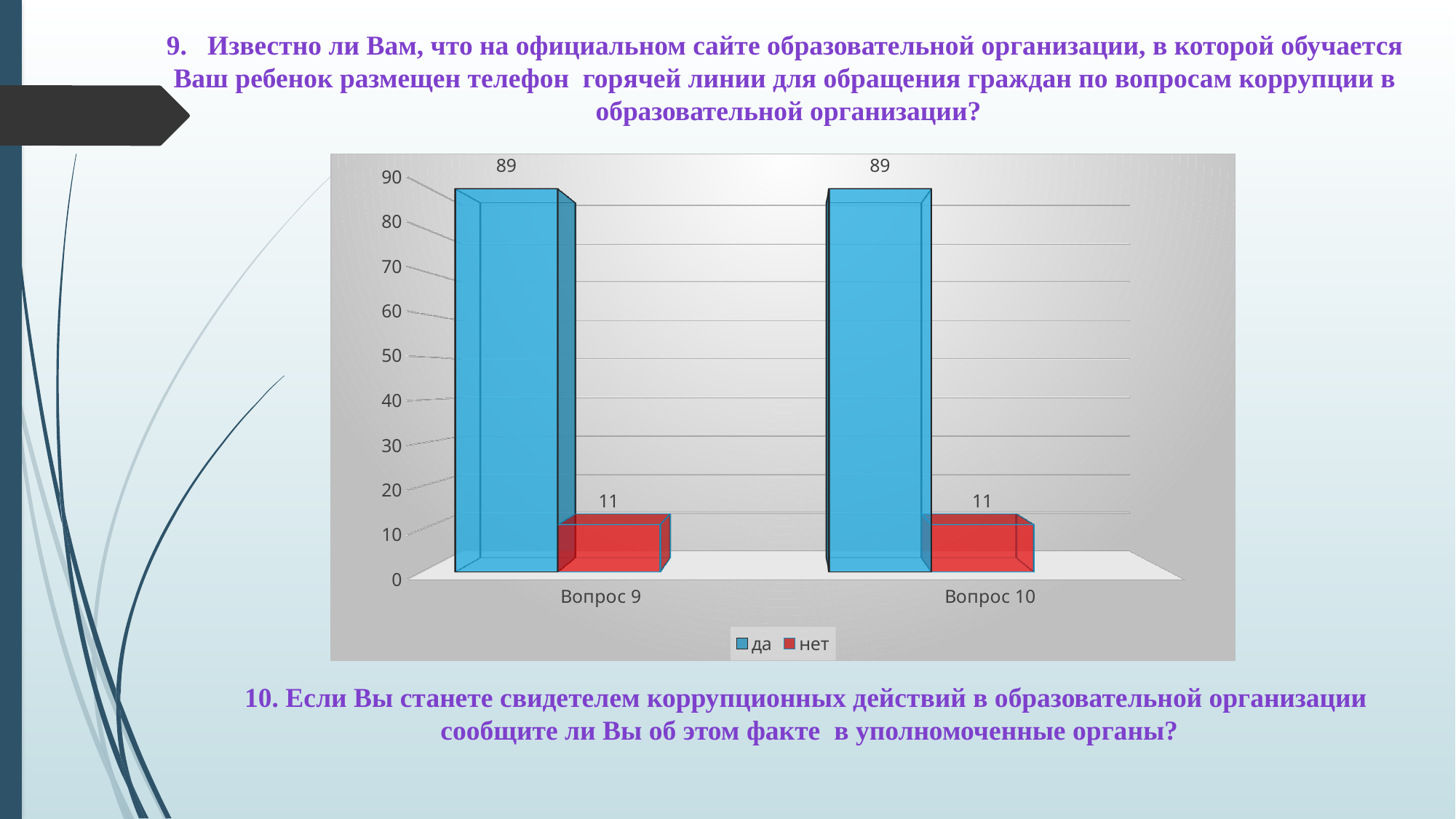
Is the value for "нет" in "Вопрос 9" greater or less than 20? less What colour are the bars for the "нет" series? red What is the value for "нет" in the "Вопрос 9" category? 11 What is the value for "да" in the "Вопрос 9" category? 89 How many categories are shown on the x axis of the chart? 2 What is the difference between the "да" and "нет" values for "Вопрос 9"? 78 What is the value for "да" in the "Вопрос 10" category? 89 What kind of chart is shown on the slide? bar chart What is the value for "нет" in the "Вопрос 10" category? 11 How many series does the legend list? 2 Which series has the larger value in the "Вопрос 10" category, "да" or "нет"? да Is the value for "да" in "Вопрос 10" greater or less than 80? greater